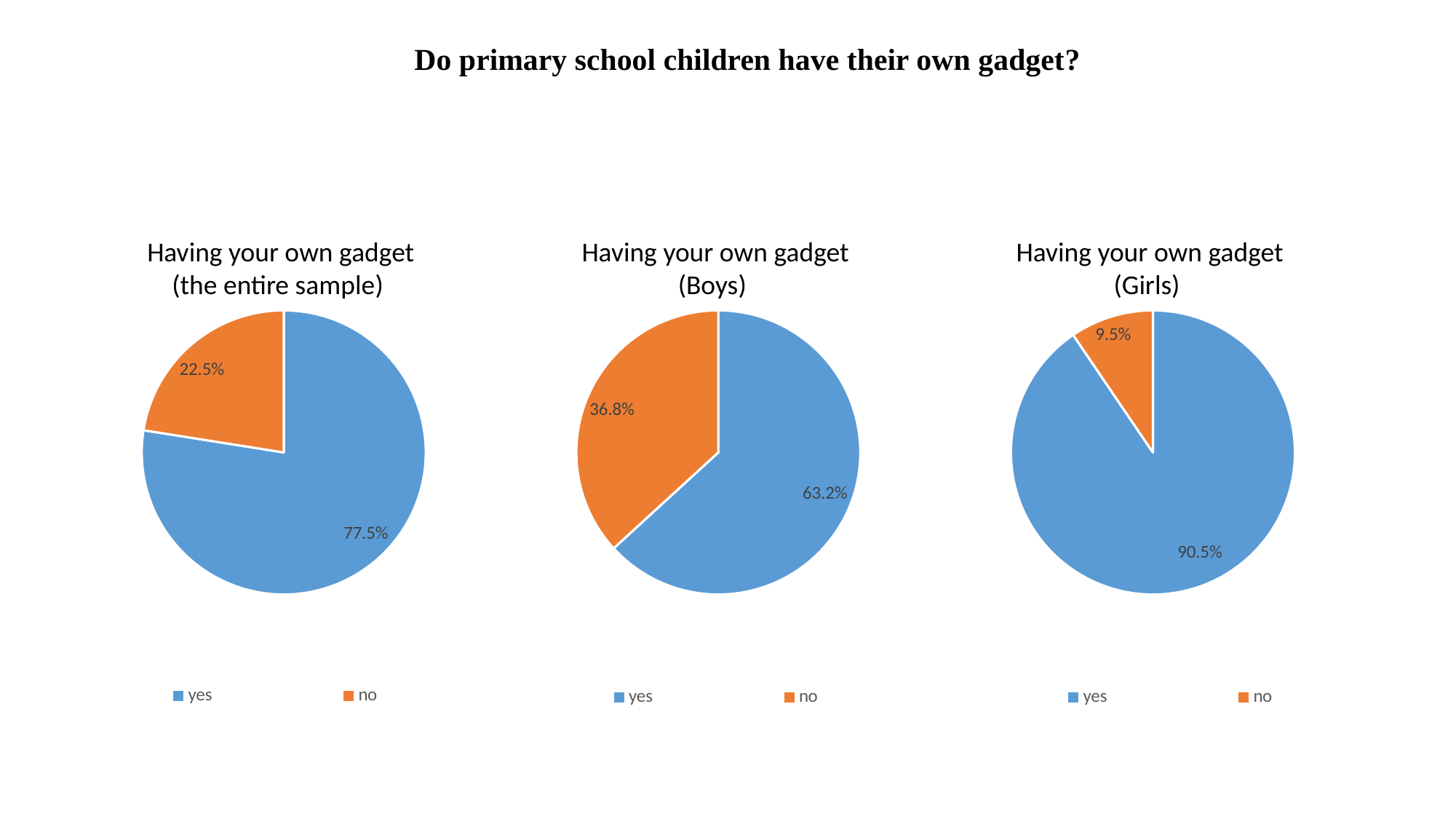
In the 'Having your own gadget (Boys)' chart, what is the difference between the yes and no percentages? 26.4% In the 'Having your own gadget (the entire sample)' chart, what percentage answered yes? 77.5% What kind of chart is the 'Having your own gadget (the entire sample)' chart? pie chart In the 'Having your own gadget (Boys)' chart, what percentage answered yes? 63.2% In the 'Having your own gadget (Girls)' chart, what percentage answered no? 9.5% In the 'Having your own gadget (Boys)' chart, what percentage answered no? 36.8% How many entries does the legend of the 'Having your own gadget (Girls)' chart list? 2 Is the 'no' share larger in the 'Having your own gadget (Boys)' chart or the 'Having your own gadget (Girls)' chart? Boys In the 'Having your own gadget (Girls)' chart, what percentage answered yes? 90.5% In the 'Having your own gadget (Boys)' chart, which slice is the largest? yes In the 'Having your own gadget (Girls)' chart, which slice is the smallest? no In the 'Having your own gadget (the entire sample)' chart, what percentage answered no? 22.5%